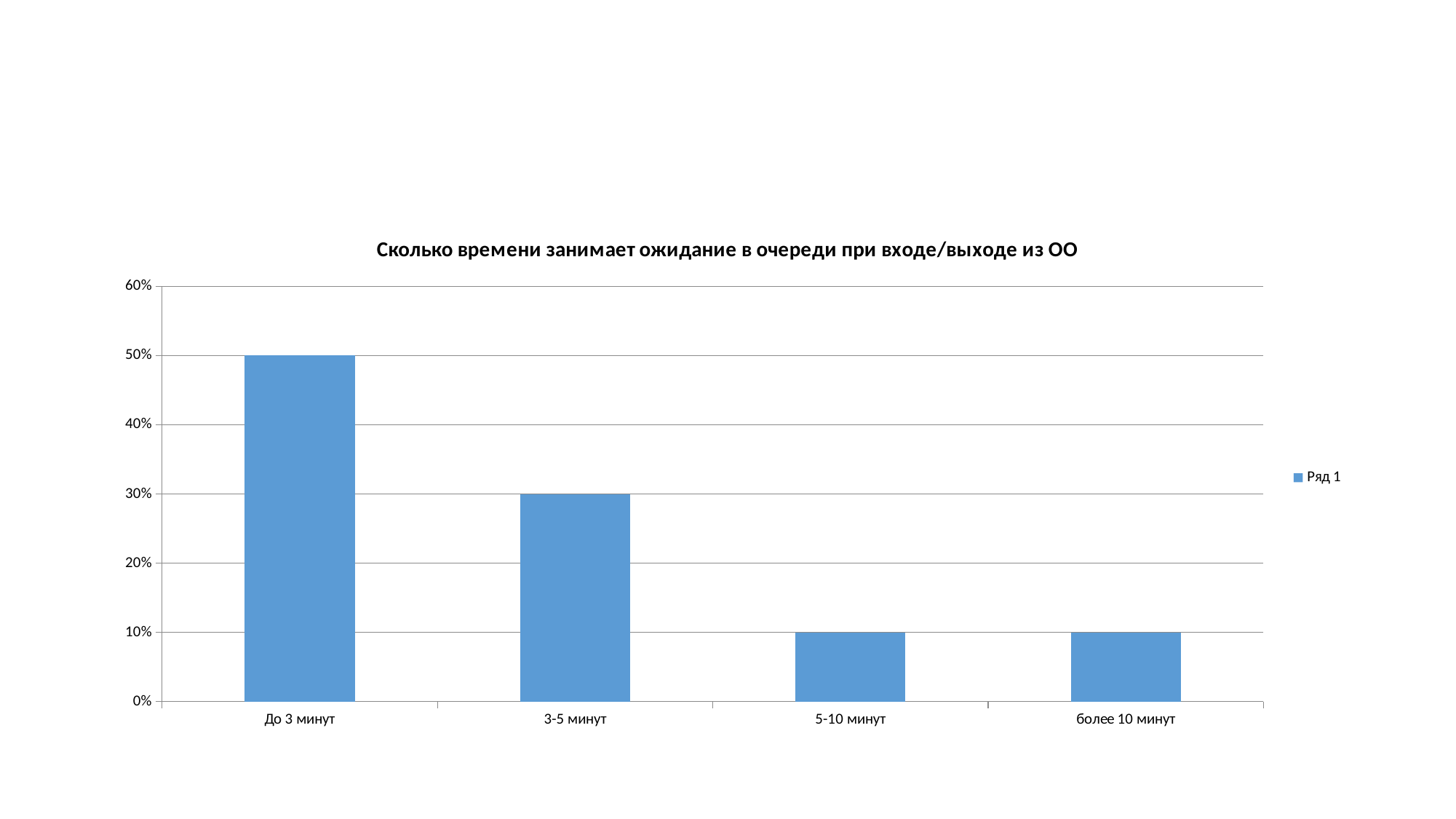
What is the value for "5-10 минут"? 10% What is the value for "3-5 минут"? 30% What is the value for "До 3 минут"? 50% What is the difference between the values for "До 3 минут" and "3-5 минут"? 20% What kind of chart is shown on the slide? bar chart Which is larger, the value for "3-5 минут" or the value for "более 10 минут"? 3-5 минут Is the value for "До 3 минут" greater or less than 40%? greater Which category has the highest value? До 3 минут Do the values rise or fall from "До 3 минут" to "5-10 минут"? fall How many categories are shown on the x axis? 4 How many series does the legend list? 1 What is the name of the series in the legend? Ряд 1